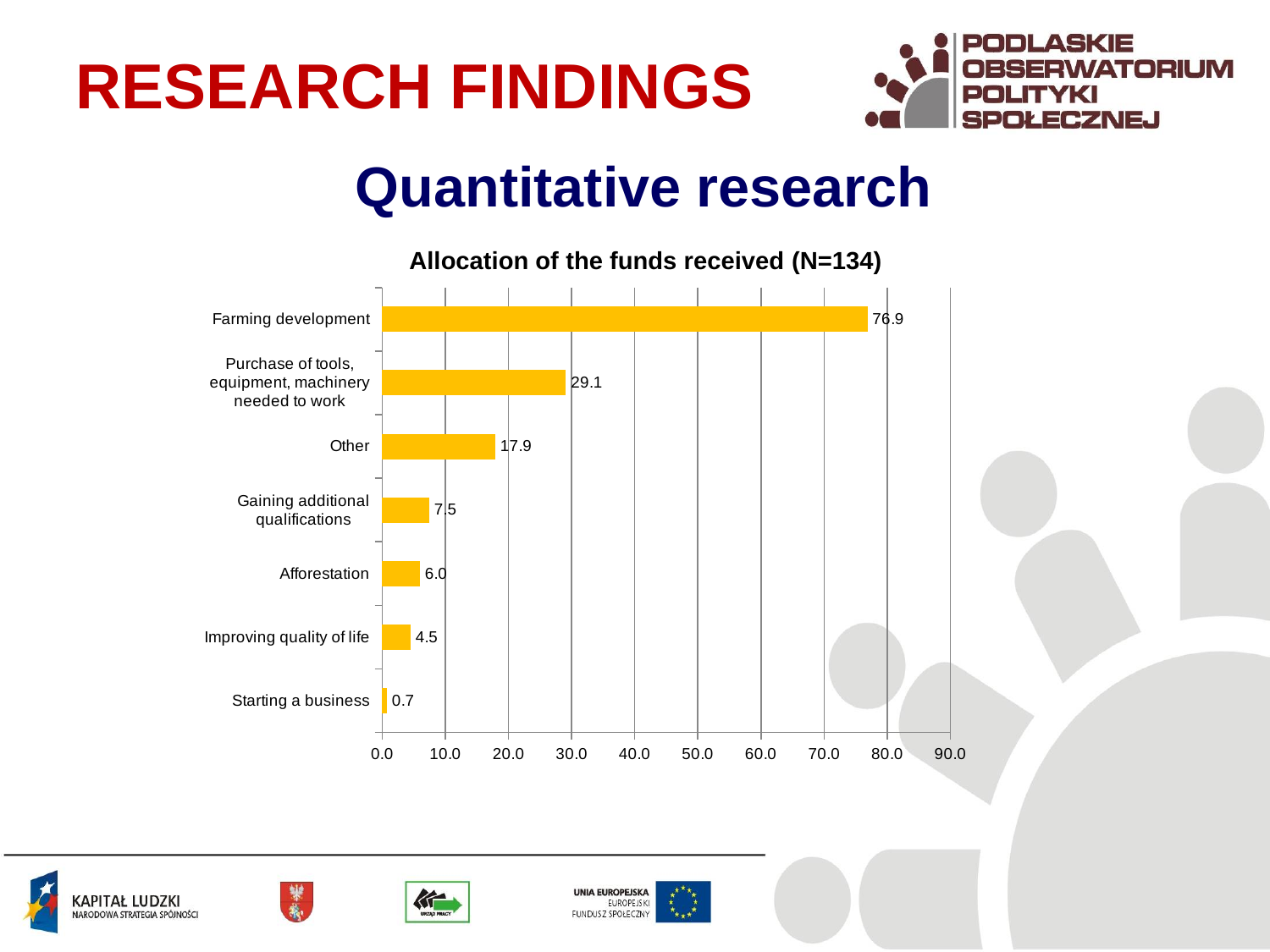
What is the value for Farming development? 76.9 Which category has the lowest value? Starting a business What is the value for Purchase of tools, equipment, machinery needed to work? 29.1 What is the difference between the values for Farming development and Other? 59.0 What is the difference between the values for Gaining additional qualifications and Improving quality of life? 3.0 What is the title of the chart? Allocation of the funds received (N=134) Which is larger, the value for Other or the value for Afforestation? Other What is the value for Afforestation? 6.0 What is the value for Starting a business? 0.7 Which category has the highest value? Farming development How many categories are shown in the chart? 7 What kind of chart is shown on the slide? Bar chart